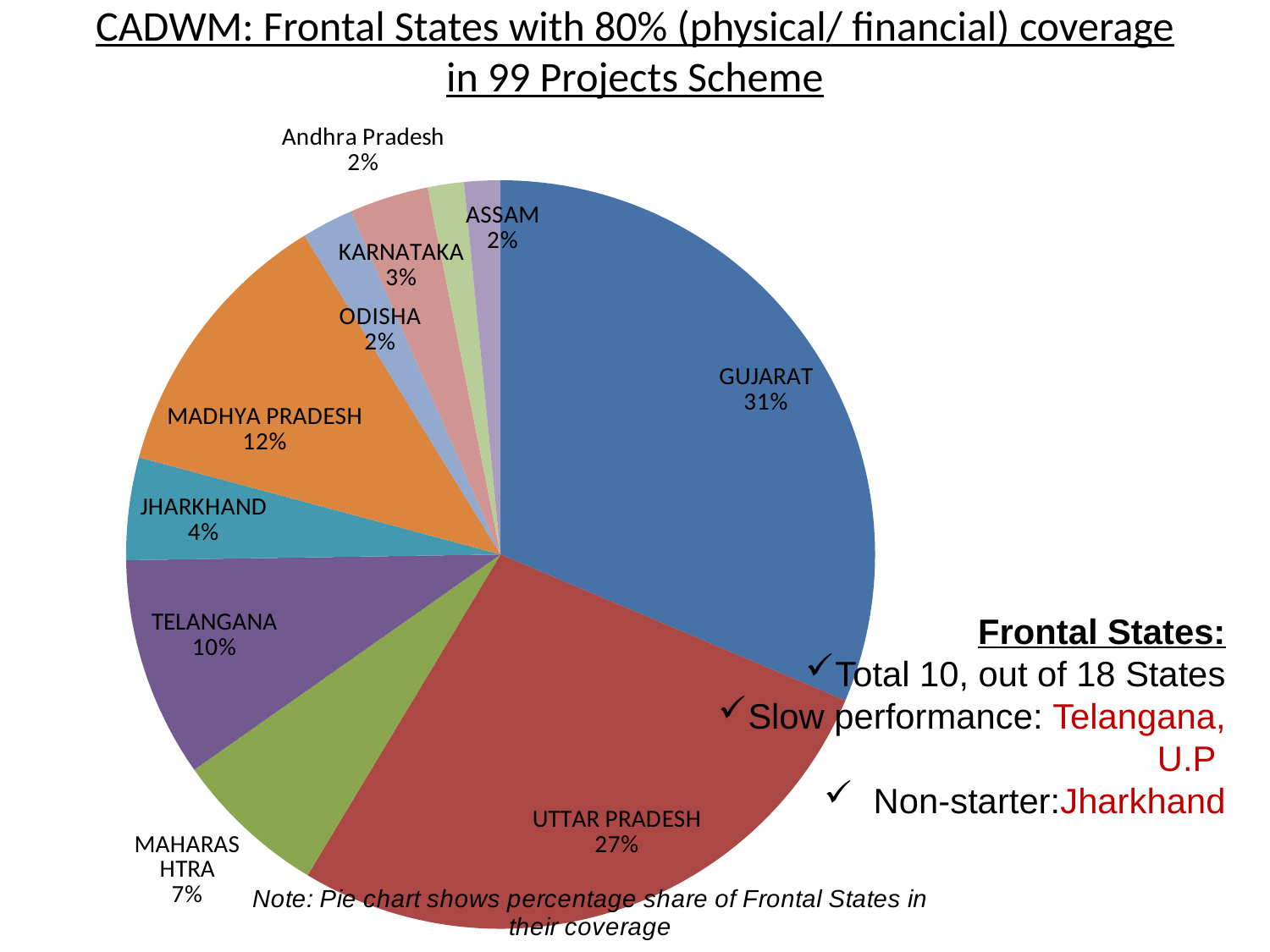
What is the percentage share for Karnataka? 3% What is the percentage share for Madhya Pradesh? 12% Which state has the largest share of the pie? Gujarat What is the percentage share for Gujarat? 31% What is the title of the slide containing the pie chart? CADWM: Frontal States with 80% (physical/ financial) coverage in 99 Projects Scheme What is the difference in percentage share between Madhya Pradesh and Jharkhand? 8% What is the percentage share for Telangana? 10% How many states (slices) are shown in the pie chart? 10 What is the percentage share for Uttar Pradesh? 27% Which has a larger share, Telangana or Maharashtra? Telangana What is the difference in percentage share between Gujarat and Uttar Pradesh? 4% What kind of chart is shown on the slide? Pie chart